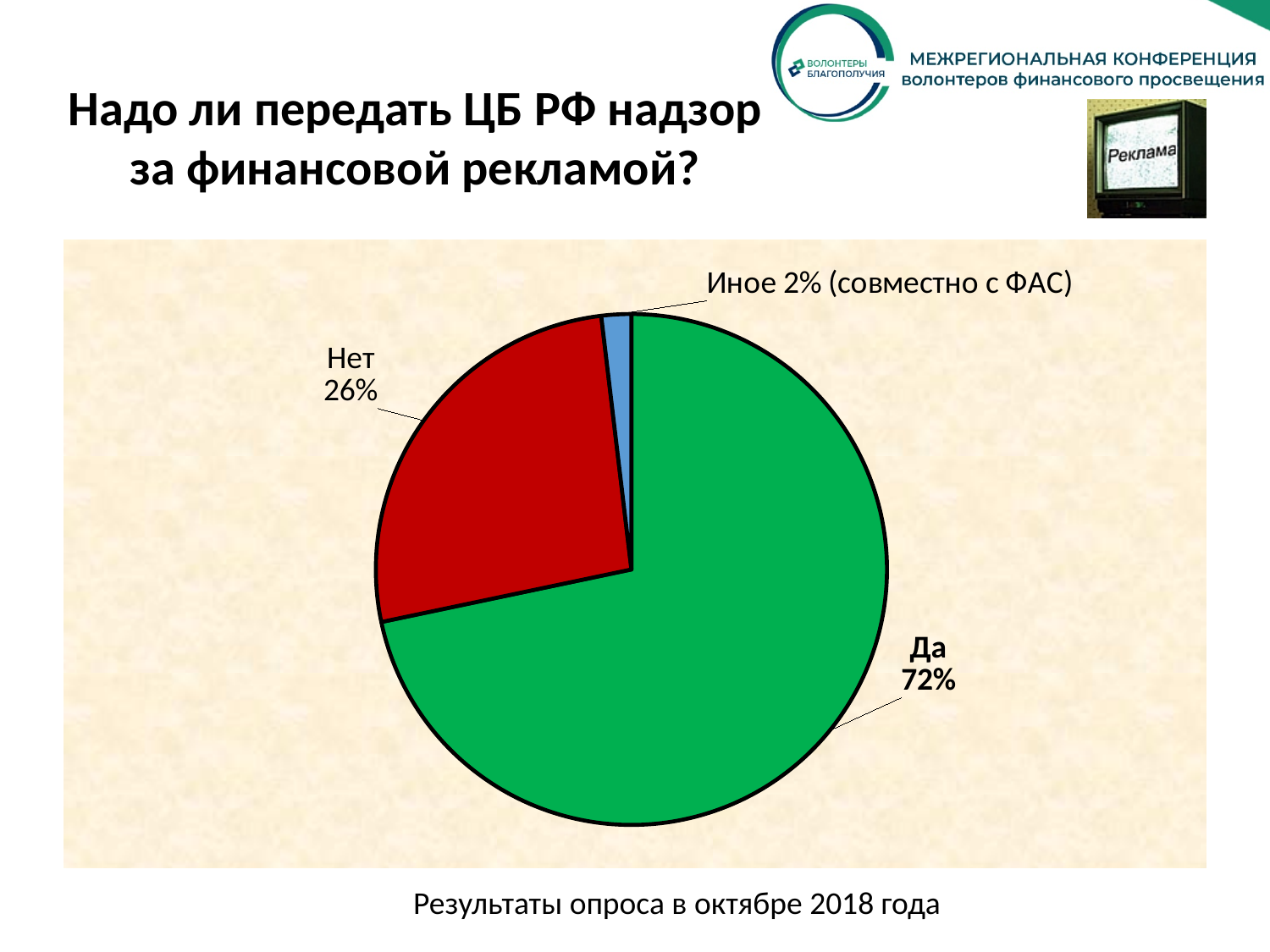
What share of respondents answered "Иное"? 2% What is the difference in percentage points between "Да" and "Нет"? 46 What is the combined share of "Нет" and "Иное"? 28% Which answer has the smallest share of the pie? Иное What share of respondents answered "Нет"? 26% Which answer has the largest share of the pie? Да How many slices does the pie chart have? 3 Which is larger, the share for "Нет" or the share for "Иное"? Нет What kind of chart is shown on the slide? pie chart What share of respondents answered "Да"? 72% According to the caption below the chart, when was the survey conducted? October 2018 What colour is the "Да" slice? green